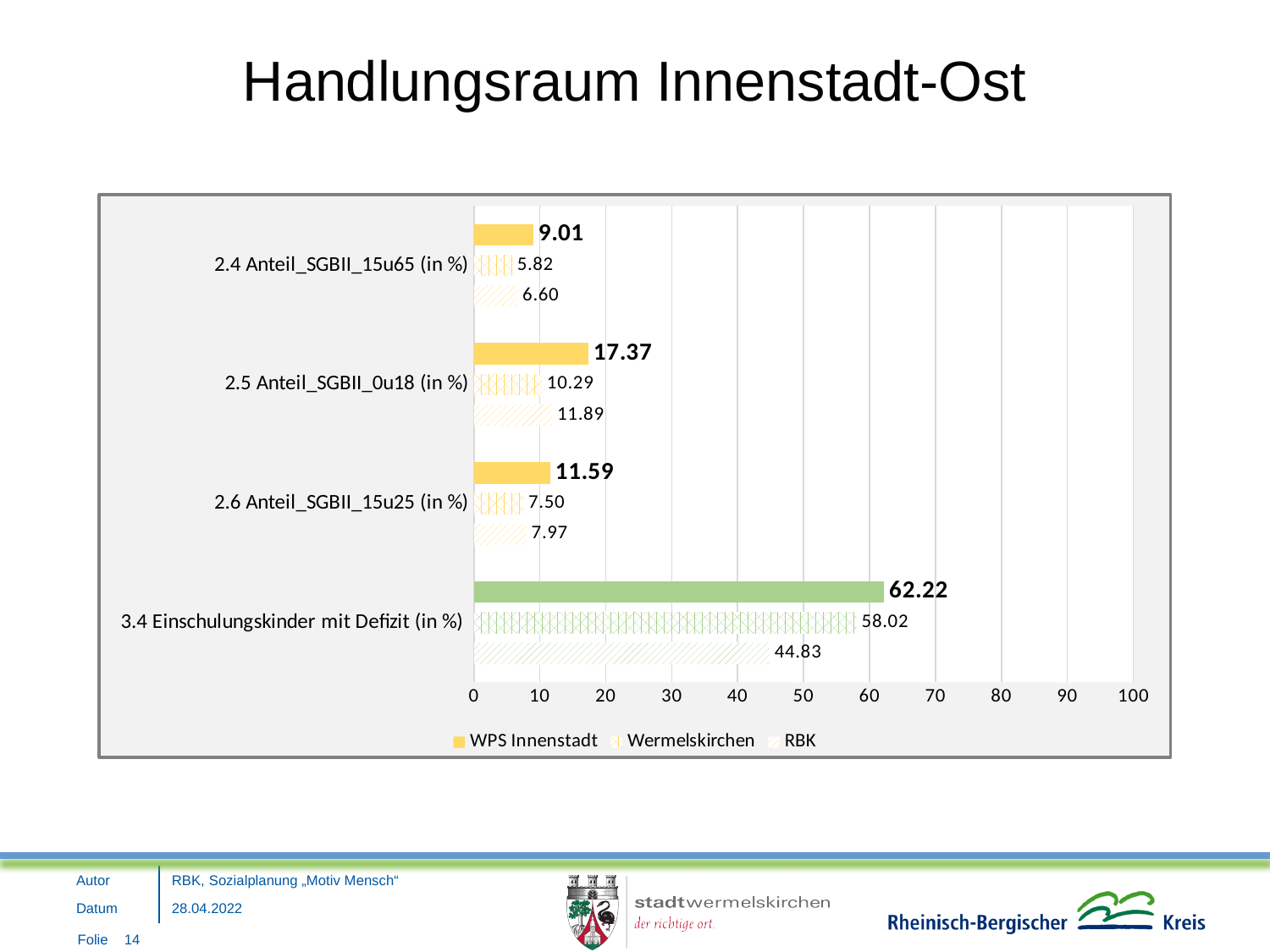
How many categories are shown on the chart? 4 What is the value for Wermelskirchen in the category "2.5 Anteil_SGBII_0u18 (in %)"? 10.29 What kind of chart is shown on the slide? Bar chart In the category "2.5 Anteil_SGBII_0u18 (in %)", which is larger: the value for Wermelskirchen or the value for RBK? RBK What is the value for WPS Innenstadt in the category "2.6 Anteil_SGBII_15u25 (in %)"? 11.59 Which category has the highest value for WPS Innenstadt? 3.4 Einschulungskinder mit Defizit (in %) What is the difference between the WPS Innenstadt value and the RBK value in the category "3.4 Einschulungskinder mit Defizit (in %)"? 17.39 What is the value for RBK in the category "2.4 Anteil_SGBII_15u65 (in %)"? 6.60 How many series does the legend list? 3 What is the value for WPS Innenstadt in the category "3.4 Einschulungskinder mit Defizit (in %)"? 62.22 Which category has the lowest value for Wermelskirchen? 2.4 Anteil_SGBII_15u65 (in %) Is the value for Wermelskirchen in the category "3.4 Einschulungskinder mit Defizit (in %)" greater or less than 50? greater